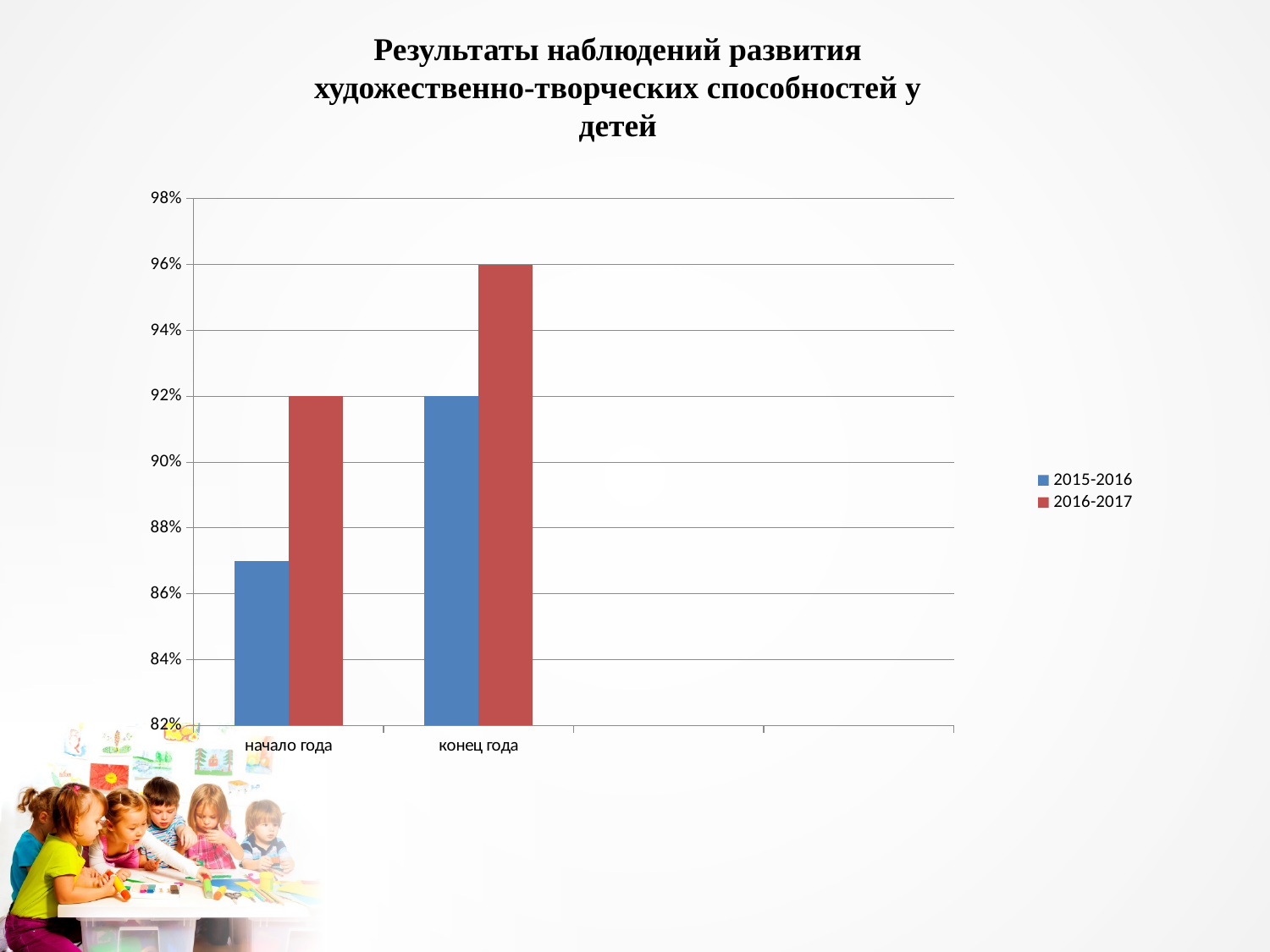
What is the value for 2016-2017 at начало года? 92% At начало года, which series has the larger value, 2015-2016 or 2016-2017? 2016-2017 For the 2015-2016 series, do the values rise or fall from начало года to конец года? rise What kind of chart is shown on the slide? bar chart At конец года, what is the difference between the 2016-2017 value and the 2015-2016 value? 4% What is the value for 2016-2017 at конец года? 96% Which bar is the lowest in the chart? 2015-2016 at начало года How many categories are shown on the x axis? 2 Which bar is the highest in the chart? 2016-2017 at конец года What is the value for 2015-2016 at конец года? 92% Is the value for 2015-2016 at начало года greater or less than 88%? less How many series does the legend list? 2